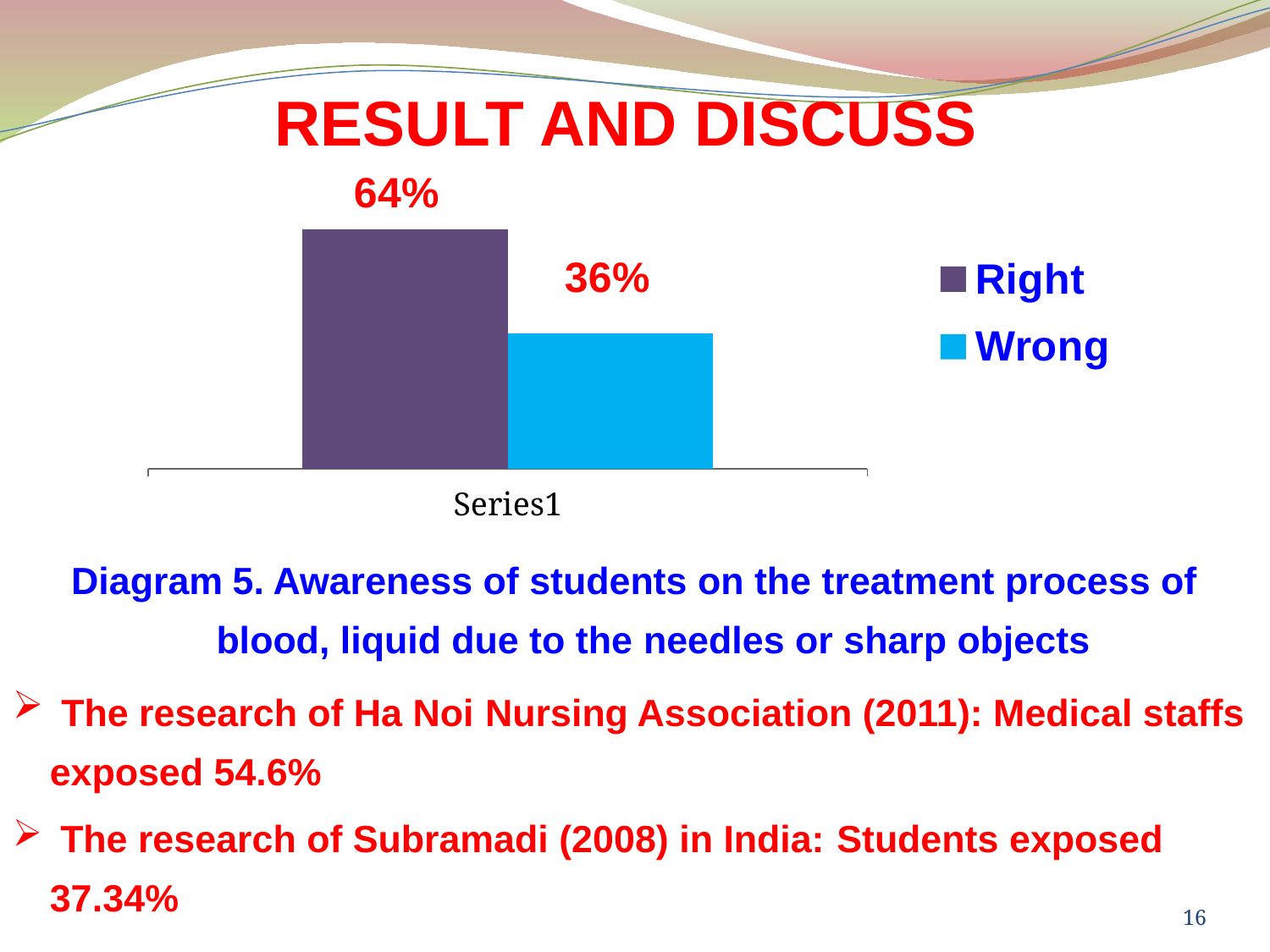
Which series has the lowest value? Wrong What is the difference between the Right and Wrong values? 28% What is the value for Wrong? 36% What is the total of the Right and Wrong values? 100% What kind of chart is shown on the slide? Bar chart What is the value for Right? 64% What is the category label shown on the x axis? Series1 Which is larger, the value for Right or the value for Wrong? Right How many series does the legend list? 2 Which series has the highest value? Right What colour is the bar for Wrong? Light blue